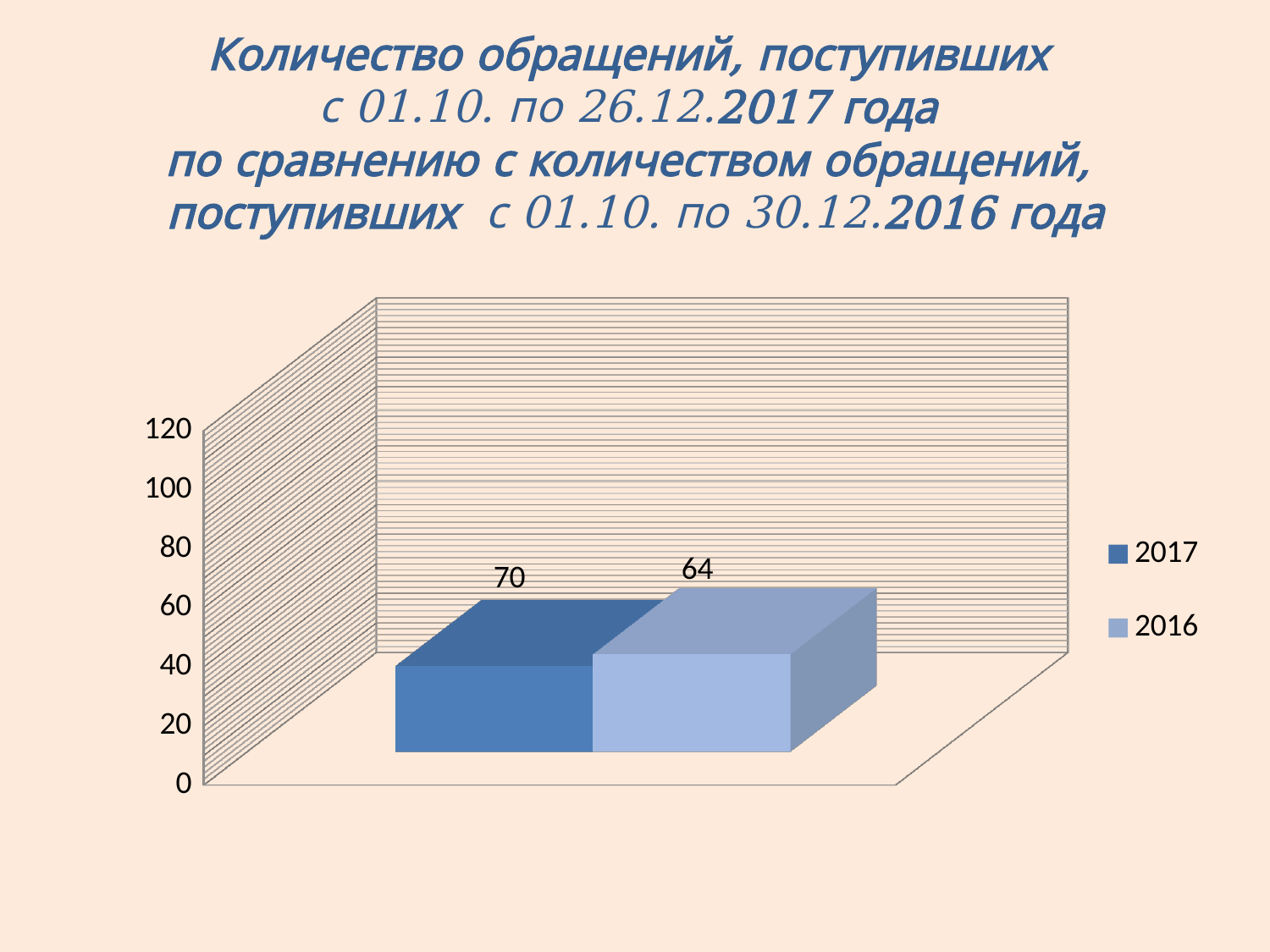
Is the value for 2017 greater or less than 100? less What is the difference between the values for 2017 and 2016? 6 What kind of chart is shown on the slide? bar chart Which series is shown in the darker blue colour? 2017 What is the value for 2017? 70 Which series has the lowest value? 2016 Is the value for 2016 greater or less than 40? greater How many series does the legend list? 2 Which series has the higher value, 2017 or 2016? 2017 What is the highest value shown on the vertical axis? 120 What is the value for 2016? 64